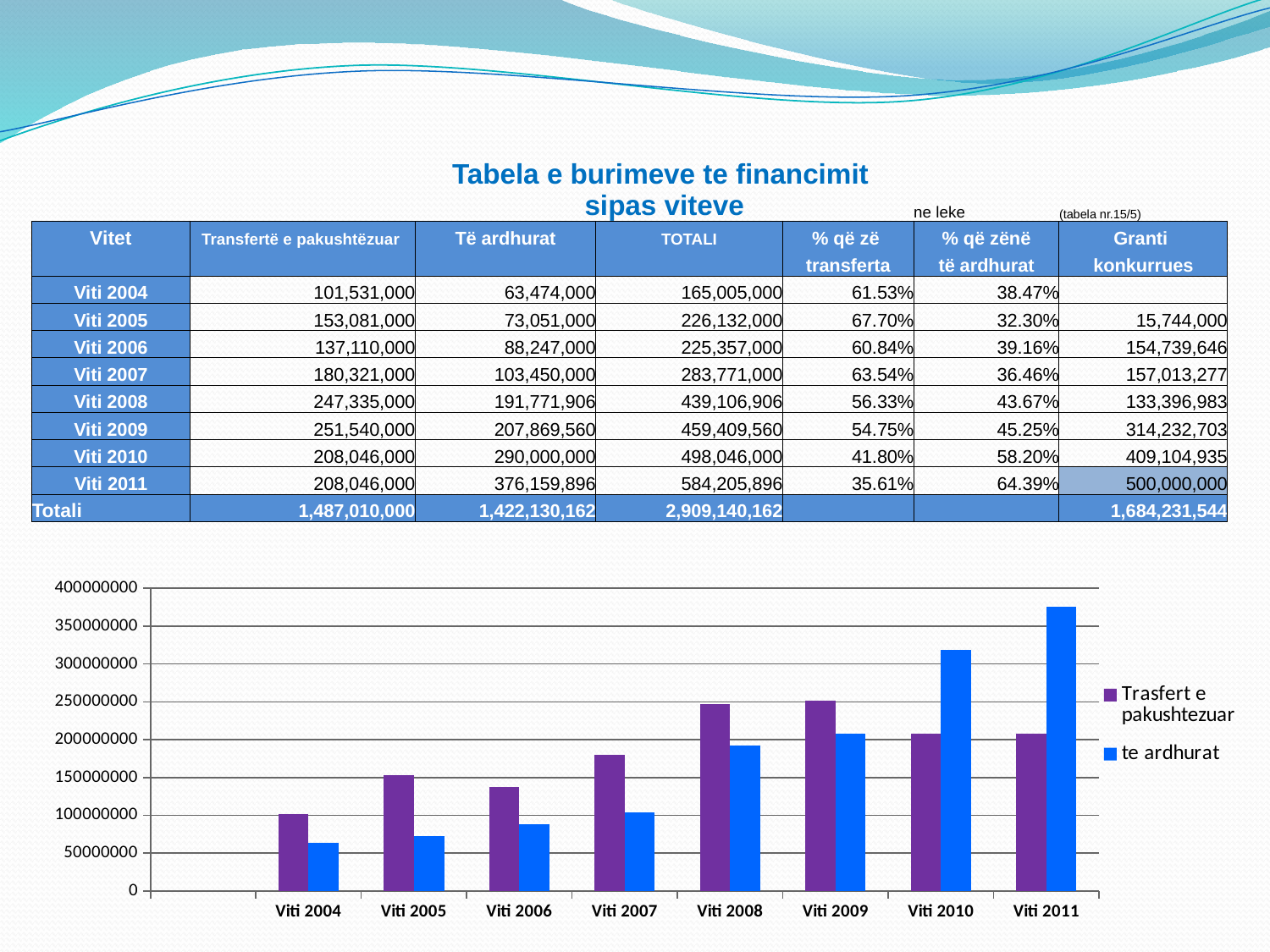
In Viti 2005, which is larger: Trasfert e pakushtezuar or te ardhurat? Trasfert e pakushtezuar In the chart, which year has the highest value for te ardhurat? Viti 2011 In the chart, which year has the lowest value for Trasfert e pakushtezuar? Viti 2004 Is the value for Trasfert e pakushtezuar in Viti 2007 greater or less than 150000000? greater Do the values for te ardhurat rise or fall from Viti 2004 to Viti 2011? rise What kind of chart is shown at the bottom of the slide? bar chart How many years (categories) are shown on the x axis of the chart? 8 In the chart, which year has the lowest value for te ardhurat? Viti 2004 How many series does the chart's legend list? 2 In Viti 2010, which is larger: Trasfert e pakushtezuar or te ardhurat? te ardhurat Is the value for te ardhurat in Viti 2004 greater or less than 100000000? less Is the value for te ardhurat in Viti 2011 greater or less than 350000000? greater